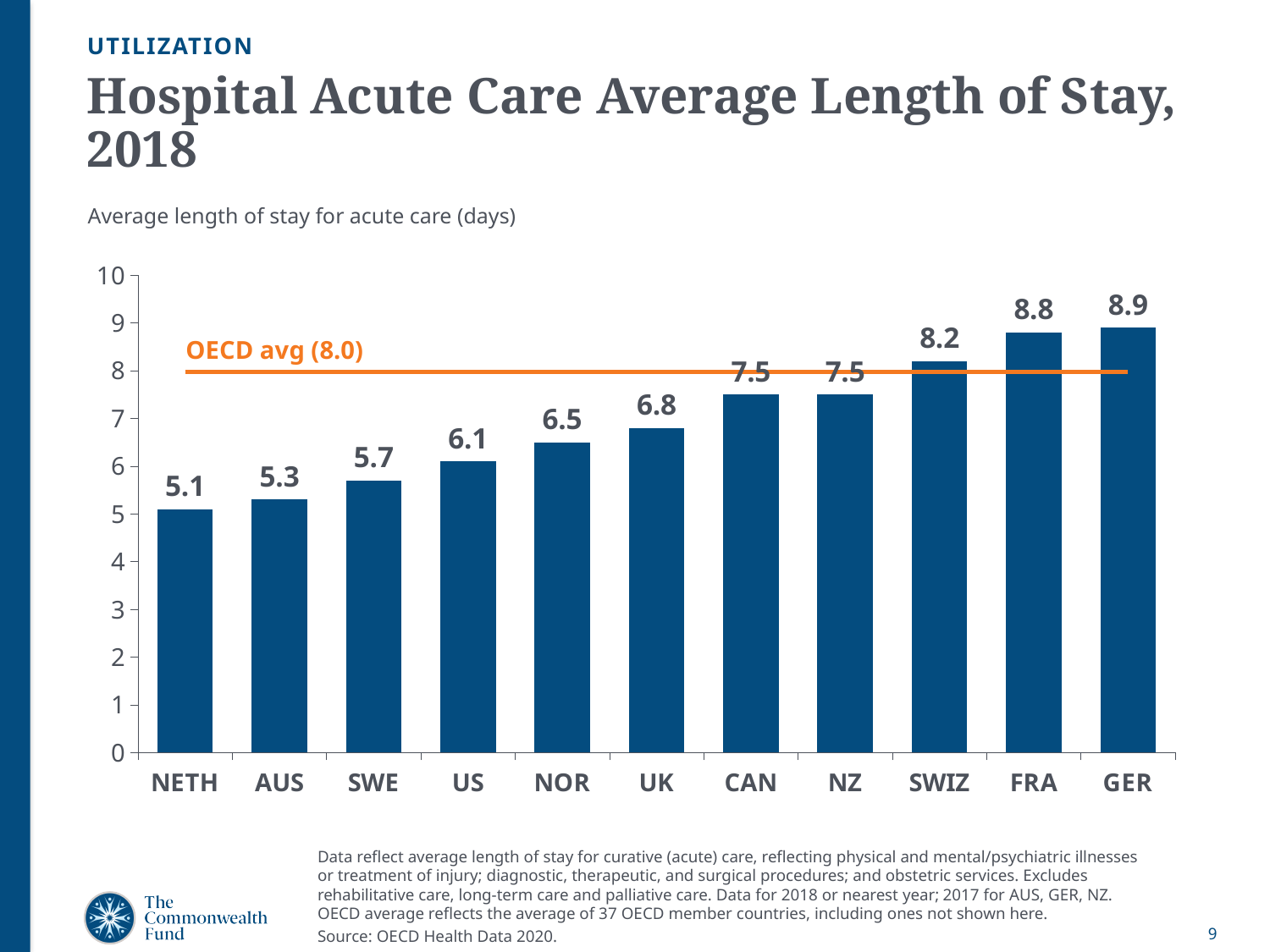
What kind of chart is shown on the slide? Bar chart What value does the orange OECD average line represent? 8.0 What is the average length of stay for acute care in the US? 6.1 What is the average length of stay for acute care in SWIZ? 8.2 How many countries are shown on the chart? 11 Which country has the lowest average length of stay? NETH Is the value for CAN greater or less than 8? less What is the difference in average length of stay between GER and NETH? 3.8 Which country has the highest average length of stay? GER What is the difference in average length of stay between FRA and UK? 2.0 Which has a longer average length of stay, NOR or AUS? NOR Do the values rise or fall from left to right across the countries? Rise